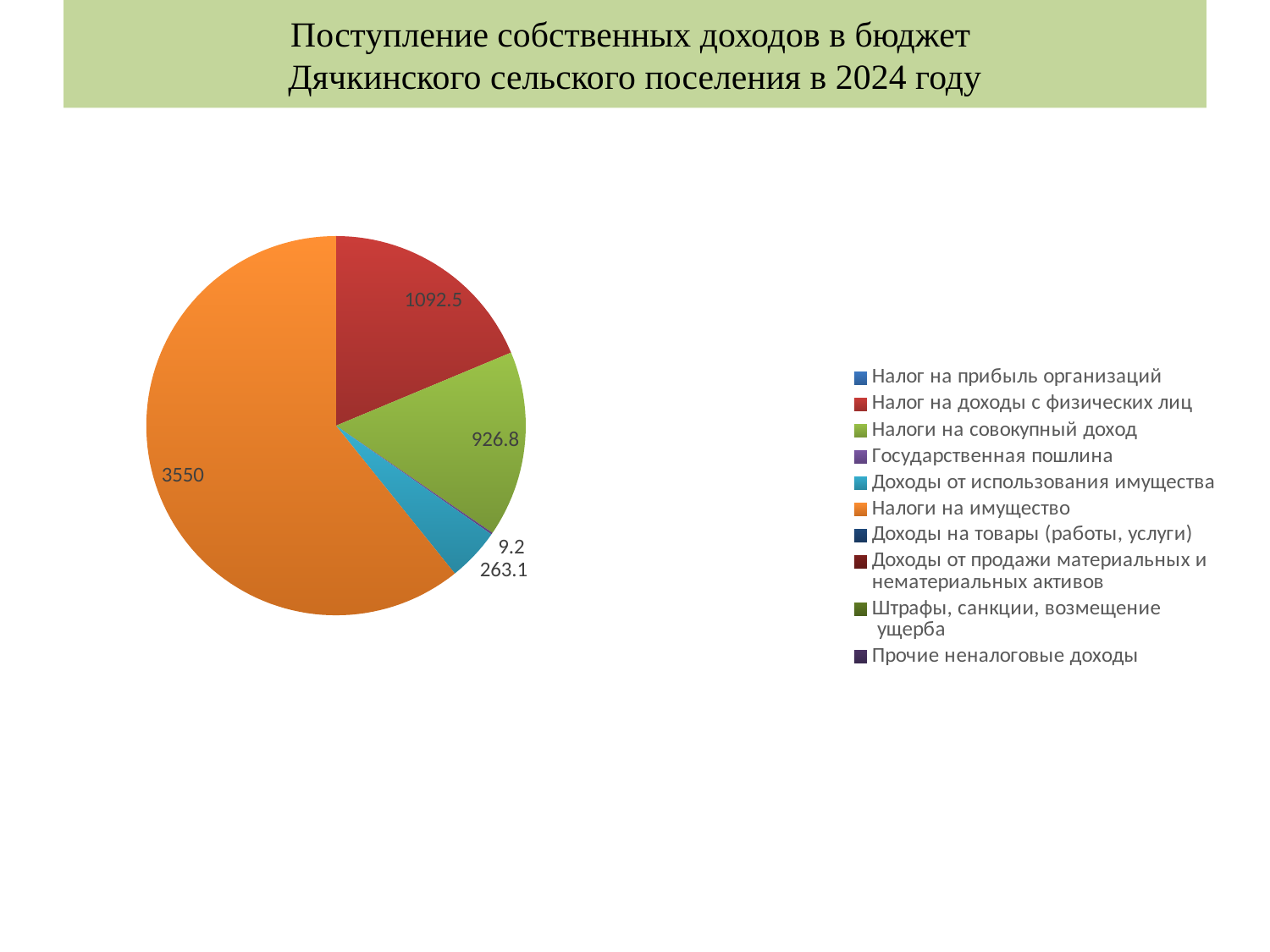
Which is larger, Налог на доходы с физических лиц or Налоги на совокупный доход? Налог на доходы с физических лиц What is the value for Налоги на совокупный доход? 926.8 What type of chart is shown on the slide? pie chart What is the difference between Доходы от использования имущества and Государственная пошлина? 253.9 What is the value for Налоги на имущество? 3550 How many entries does the legend list? 10 What is the value for Государственная пошлина? 9.2 What is the value for Налог на доходы с физических лиц? 1092.5 Which category has the largest slice of the pie? Налоги на имущество What is the difference between Налоги на имущество and Налог на доходы с физических лиц? 2457.5 What is the value for Доходы от использования имущества? 263.1 What is the title of the slide? Поступление собственных доходов в бюджет Дячкинского сельского поселения в 2024 году